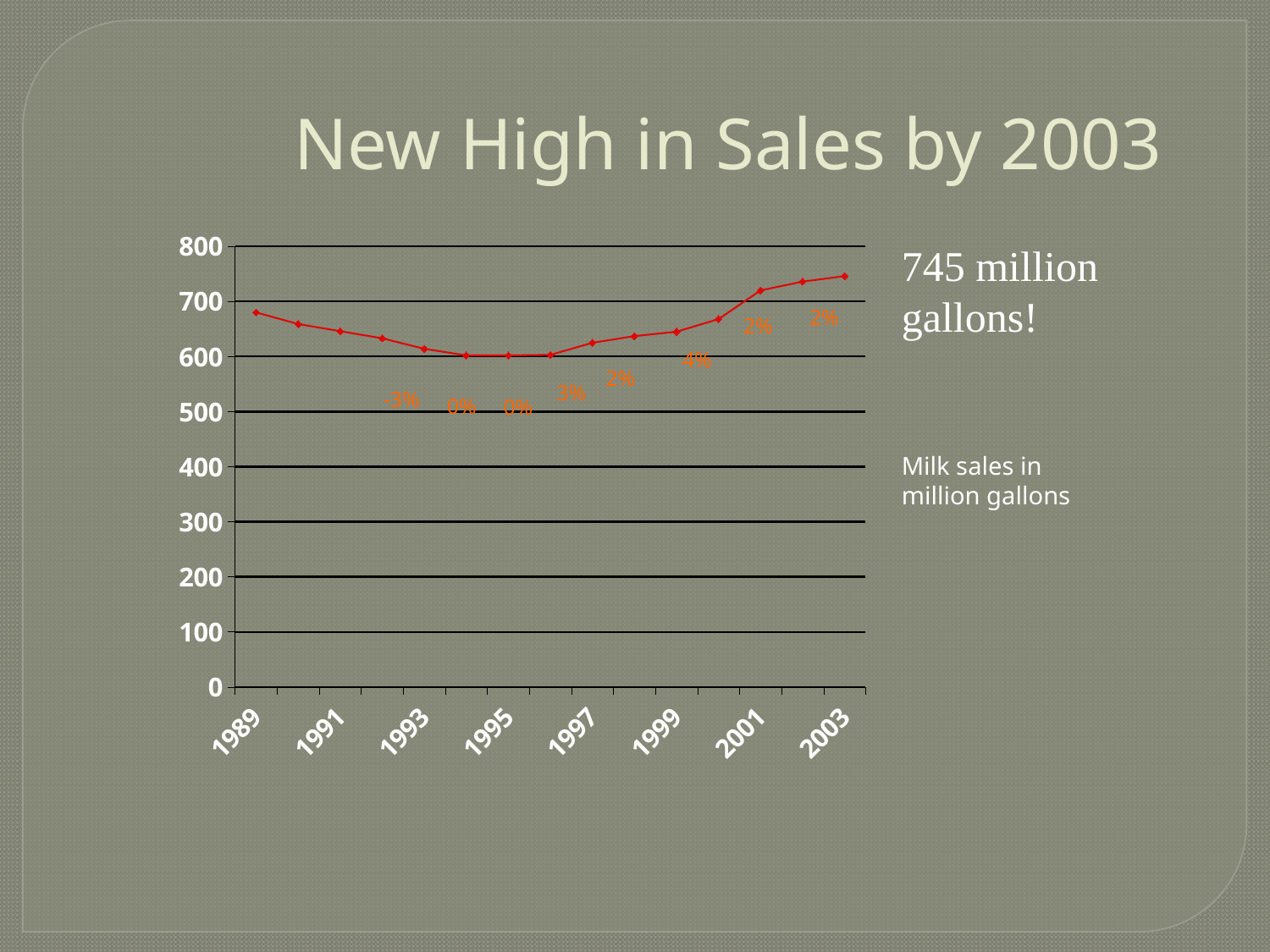
Do milk sales rise or fall from 1989 to 1994? fall Is the value for 1989 greater or less than 600? greater Which year has higher milk sales, 1989 or 2003? 2003 What are the milk sales in 2003 according to the slide? 745 million gallons Is the value for 1995 greater or less than 700? less In what units are milk sales plotted on the chart? million gallons Is the value for 2003 greater or less than 700? greater Which year has higher milk sales, 1989 or 1995? 1989 What kind of chart is shown on the slide? line chart Which year has the highest milk sales on the chart? 2003 Do milk sales rise or fall from 1996 to 2003? rise What is the title of the slide's chart? New High in Sales by 2003